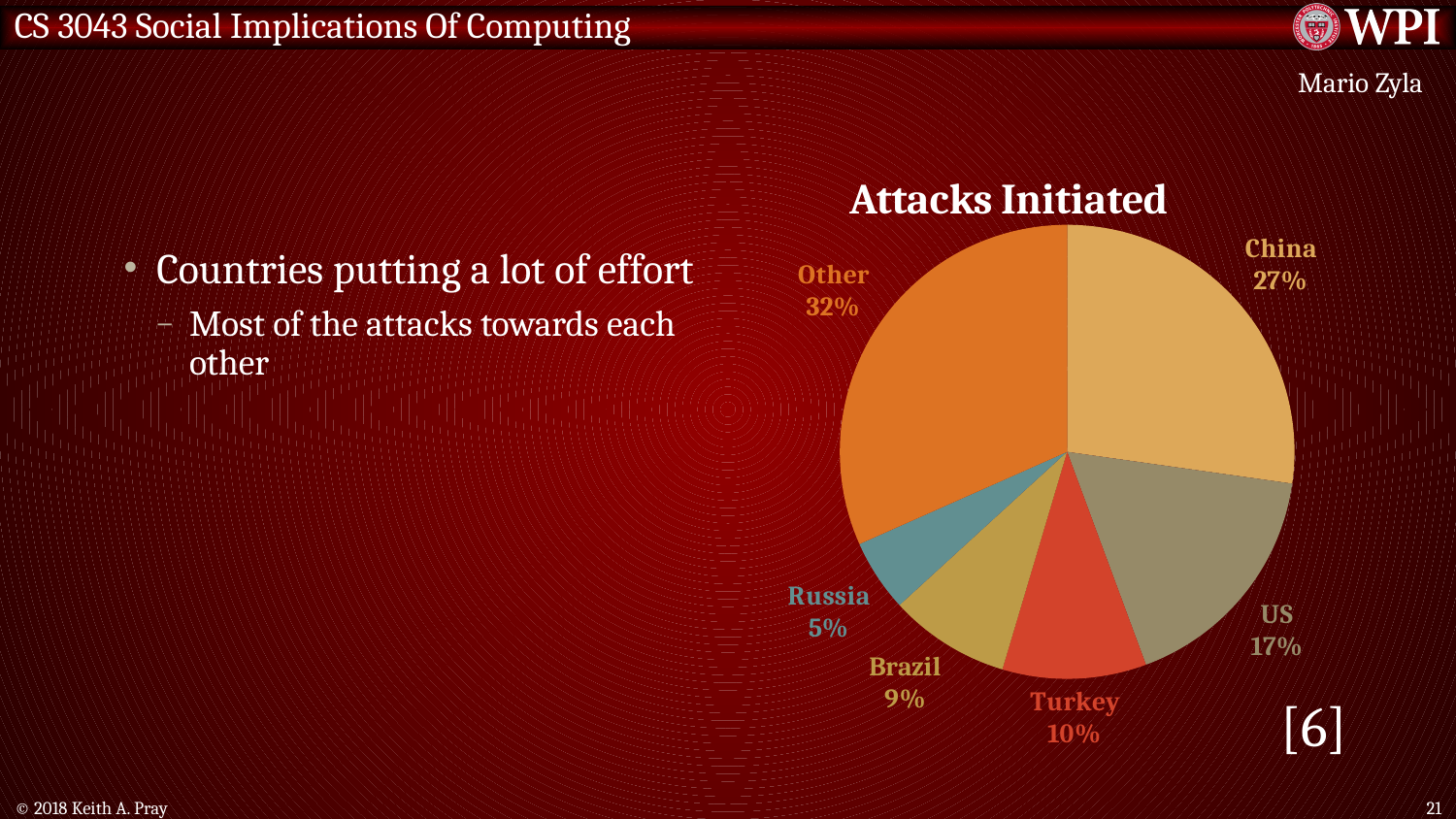
How many slices does the pie chart have? 6 What share of attacks initiated is attributed to Russia? 5% What is the title of the chart? Attacks Initiated What is the combined share of China and the US? 44% What share of attacks initiated is attributed to the US? 17% What share of attacks initiated is attributed to China? 27% What kind of chart is shown on the slide? pie chart Which has a larger share of attacks initiated, Brazil or Turkey? Turkey What is the difference in percentage points between China's share and the US share? 10 What share of attacks initiated is attributed to Turkey? 10% Which named country has the smallest share of attacks initiated? Russia Which slice of the pie chart is the largest? Other